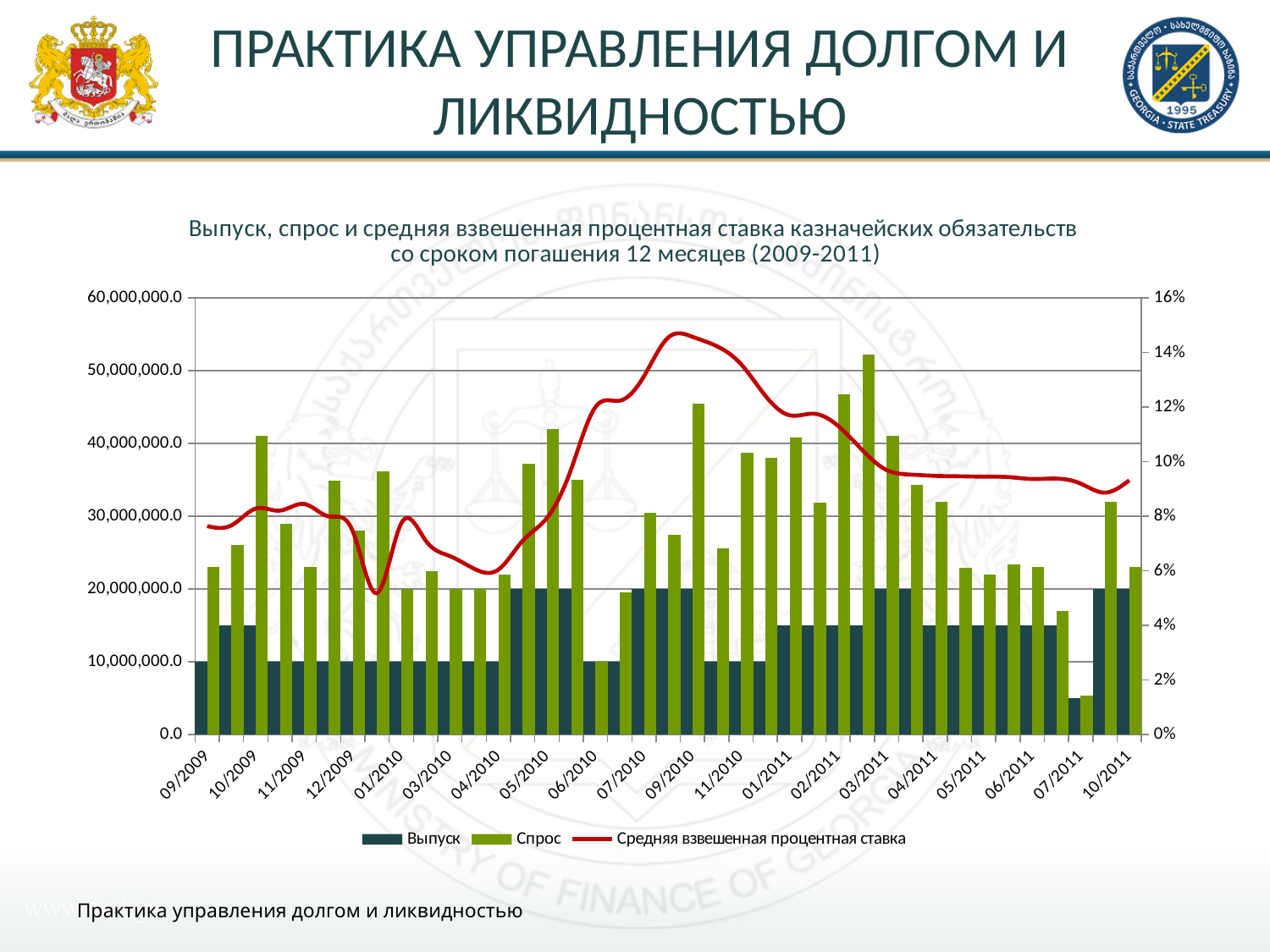
Does the Средняя взвешенная процентная ставка line rise or fall between 09/2010 and 10/2011? fall Is the Средняя взвешенная процентная ставка for 09/2010 greater or less than 14%? greater What is the Выпуск value for 09/2009? 10,000,000.0 Which series is drawn as a red line? Средняя взвешенная процентная ставка Is the Средняя взвешенная процентная ставка for 10/2011 greater or less than 10%? less Is the lowest Выпуск value on the chart greater or less than 10,000,000.0? less What kind of chart is shown on the slide? bar chart with a line Does the Средняя взвешенная процентная ставка line rise or fall between 04/2010 and 09/2010? rise How many series does the legend list? 3 Which is larger for 09/2009, Выпуск or Спрос? Спрос What is the maximum value shown on the right-hand percentage axis? 16%